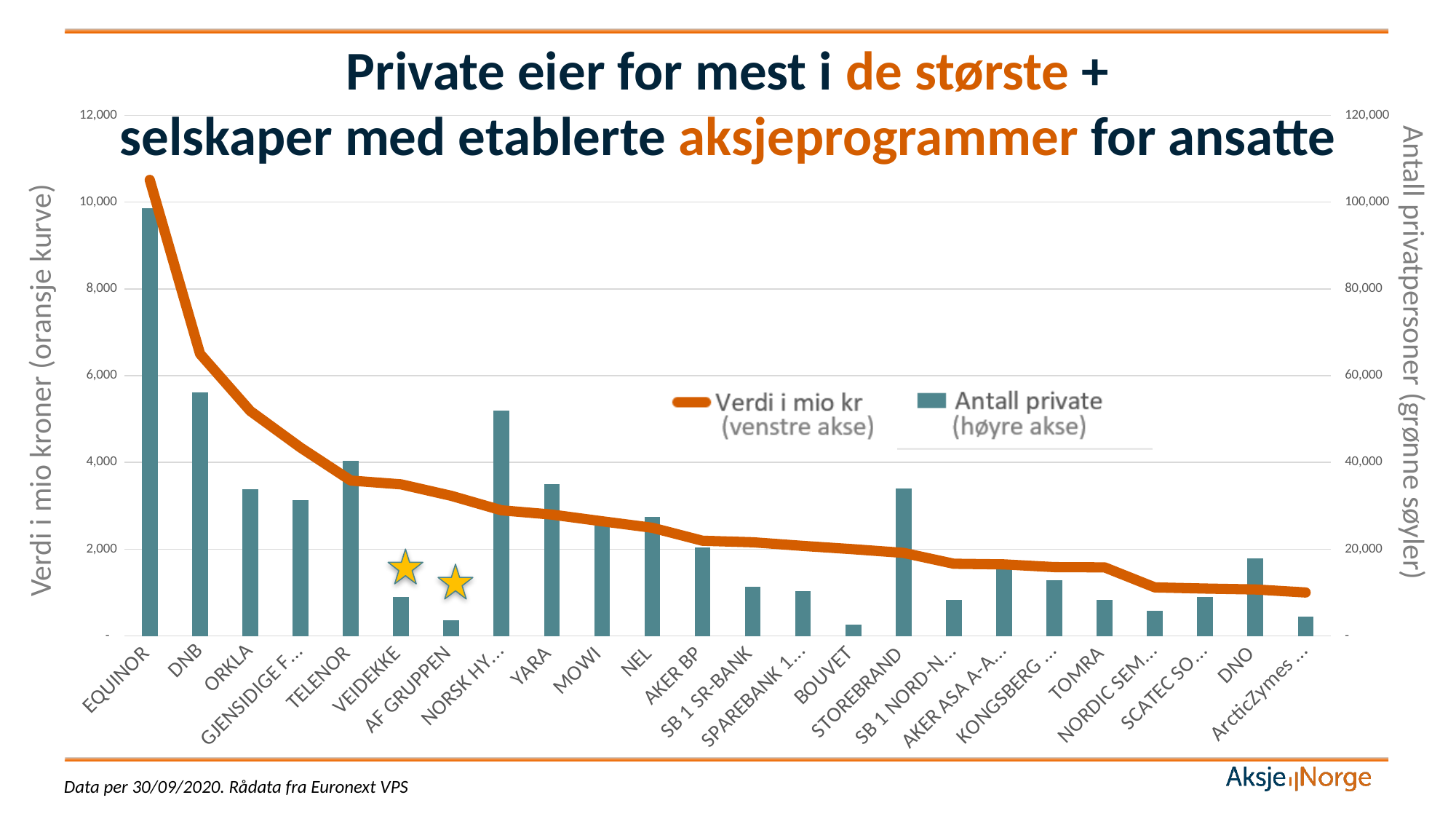
Is the Verdi i mio kr value for EQUINOR greater or less than 10,000? greater Is the Verdi i mio kr value for DNB greater or less than 8,000? less According to the legend, which axis do the green bars (Antall private) use? Høyre akse (right axis) Which has the higher Antall private bar, DNB or TELENOR? DNB Which company has the lowest value on the Verdi i mio kr line? ArcticZymes Which company has the highest bar for Antall private? EQUINOR Which has the higher Antall private bar, STOREBRAND or AKER BP? STOREBRAND How many series does the legend list? 2 Is the Antall private value for EQUINOR greater or less than 80,000? greater What kind of chart is shown on the slide? A combined bar and line chart How many companies are shown along the x axis? 24 Does the Verdi i mio kr line rise or fall from left to right along the x axis? Fall